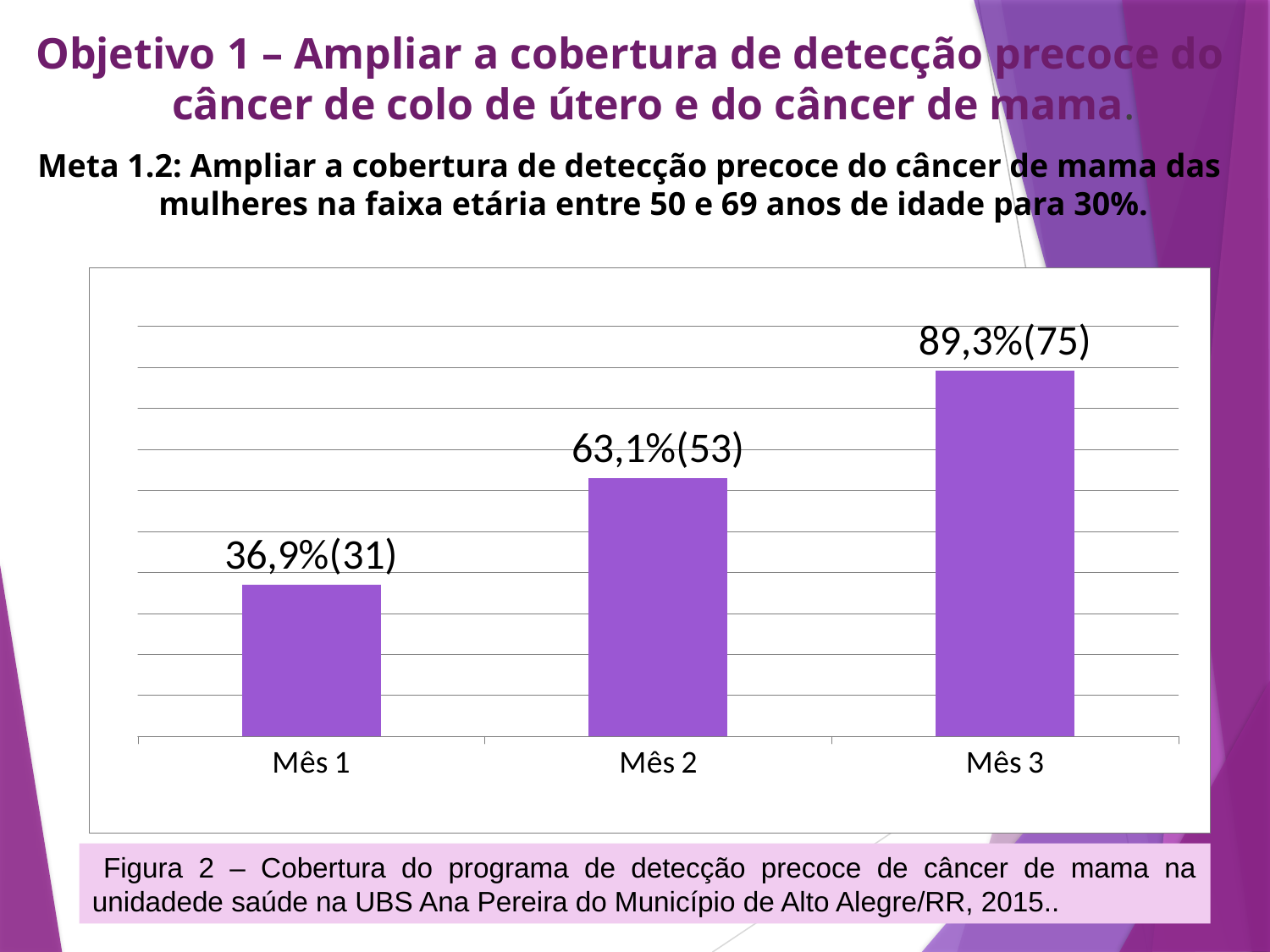
Which is larger, the value for Mês 2 or the value for Mês 1? Mês 2 How many categories (months) are plotted on the chart? 3 What is the difference in percentage between Mês 3 and Mês 1? 52,4 percentage points Do the values rise or fall from Mês 1 to Mês 3? Rise Which month has the highest bar? Mês 3 How many more women (the number in parentheses) were covered in Mês 3 than in Mês 2? 22 What value is shown for Mês 3? 89,3%(75) What colour are the bars in the chart? Purple Which month has the lowest bar? Mês 1 What value is shown for Mês 1? 36,9%(31) What value is shown for Mês 2? 63,1%(53) What kind of chart is shown on the slide? Bar chart